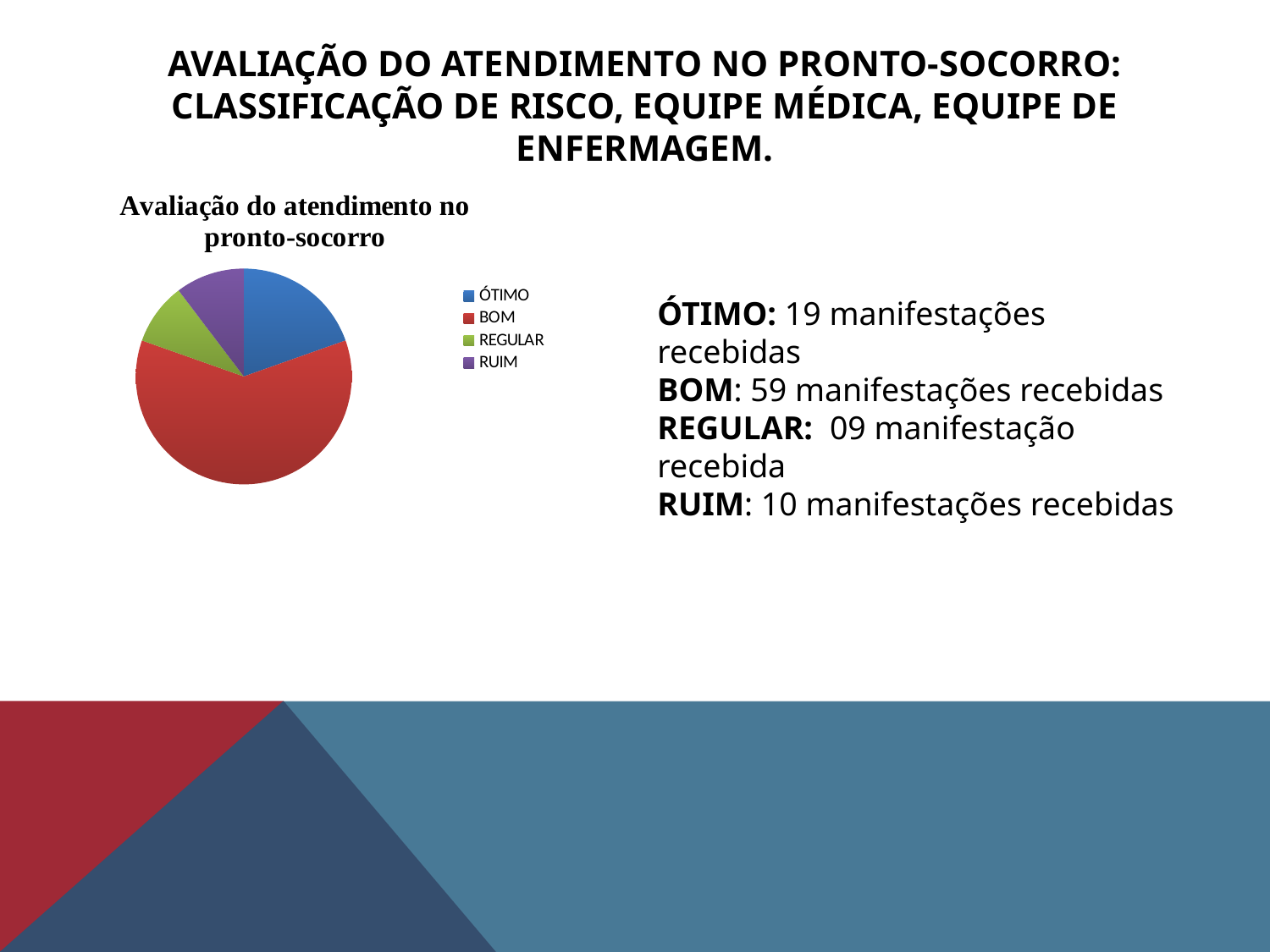
Which is larger, the slice for ÓTIMO or the slice for BOM? BOM Which is larger, the slice for ÓTIMO or the slice for RUIM? ÓTIMO What kind of chart is shown on the slide? pie chart How many manifestações were received for REGULAR? 09 What is the difference between the number of manifestações for BOM and for ÓTIMO? 40 How many categories does the pie chart have? 4 Which category has the largest slice of the pie? BOM What is the title of the chart? Avaliação do atendimento no pronto-socorro How many manifestações were received for RUIM? 10 How many manifestações were received for ÓTIMO? 19 How many manifestações were received for BOM? 59 Which colour represents BOM in the pie chart? red